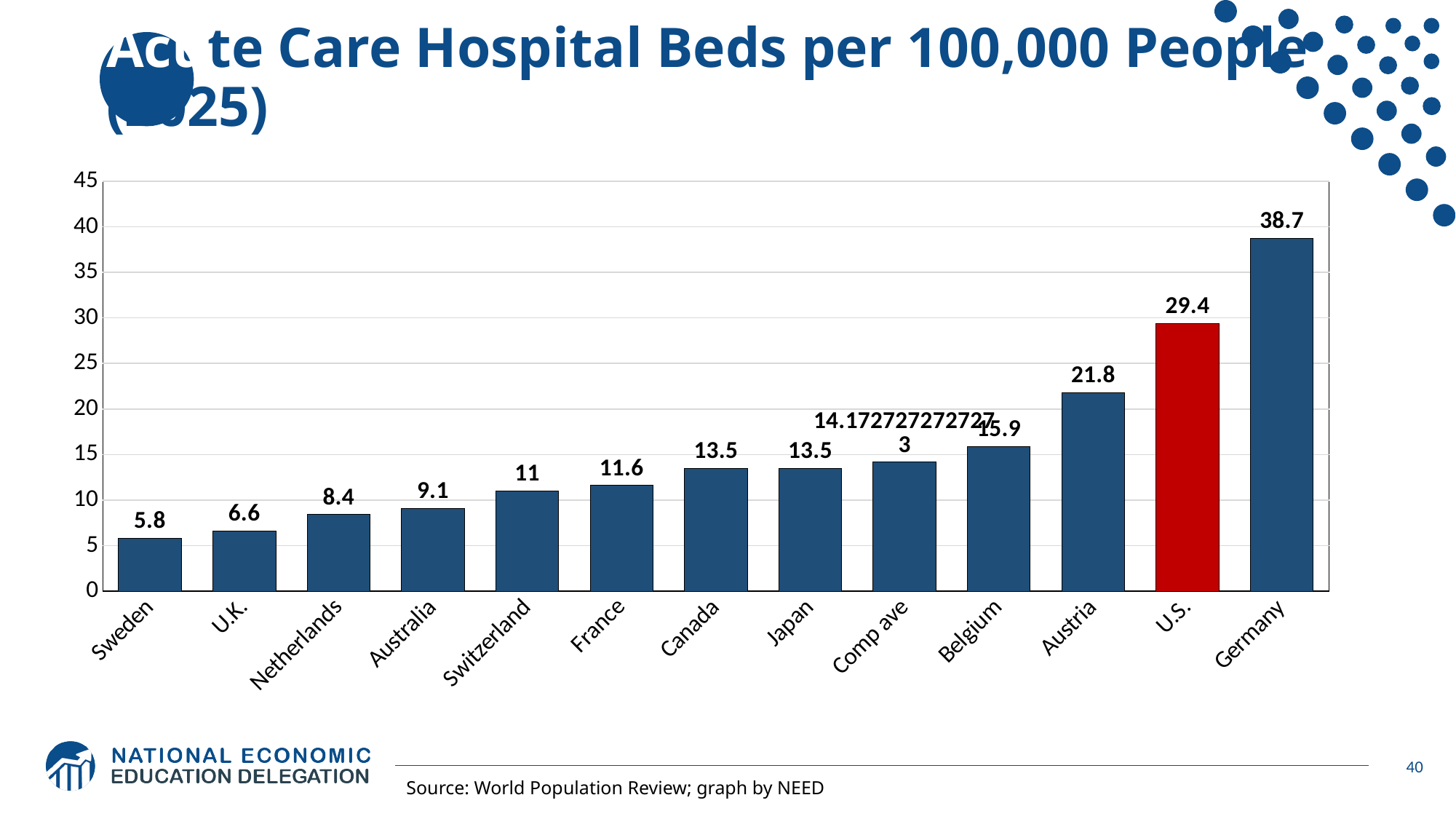
What is the value for Belgium? 15.9 Which bar is coloured red rather than blue? U.S. What kind of chart is shown on the slide? Bar chart Which has a larger value, France or Netherlands? France What is the value for the U.S.? 29.4 How many countries or categories are shown on the x axis? 13 What is the value for Germany? 38.7 Which country has the lowest value? Sweden What is the difference between the values for Austria and Belgium? 5.9 What is the difference between the values for Germany and the U.S.? 9.3 Which country has the highest value? Germany What is the value for Sweden? 5.8